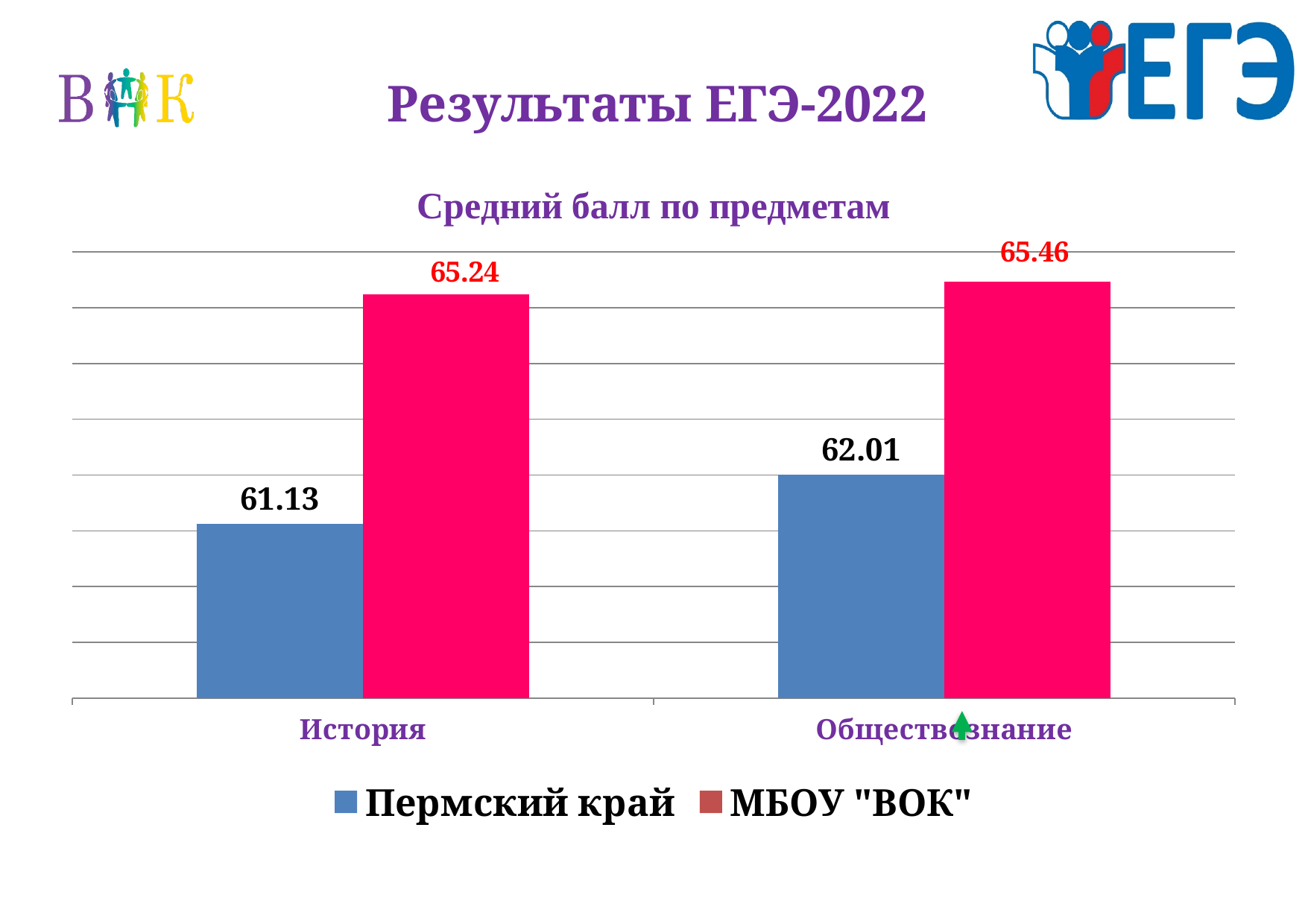
Which subject has the highest value for МБОУ "ВОК"? Обществознание How many subjects are shown on the x axis? 2 How many series does the legend list? 2 What is the average score for МБОУ "ВОК" in История? 65.24 What is the difference between the МБОУ "ВОК" and Пермский край values for Обществознание? 3.45 What is the average score for МБОУ "ВОК" in Обществознание? 65.46 What type of chart is shown on the slide? Bar chart Which subject has the lowest value for Пермский край? История What is the difference between the МБОУ "ВОК" and Пермский край values for История? 4.11 What is the average score for Пермский край in История? 61.13 Which series has the larger value for Обществознание, Пермский край or МБОУ "ВОК"? МБОУ "ВОК" What is the average score for Пермский край in Обществознание? 62.01